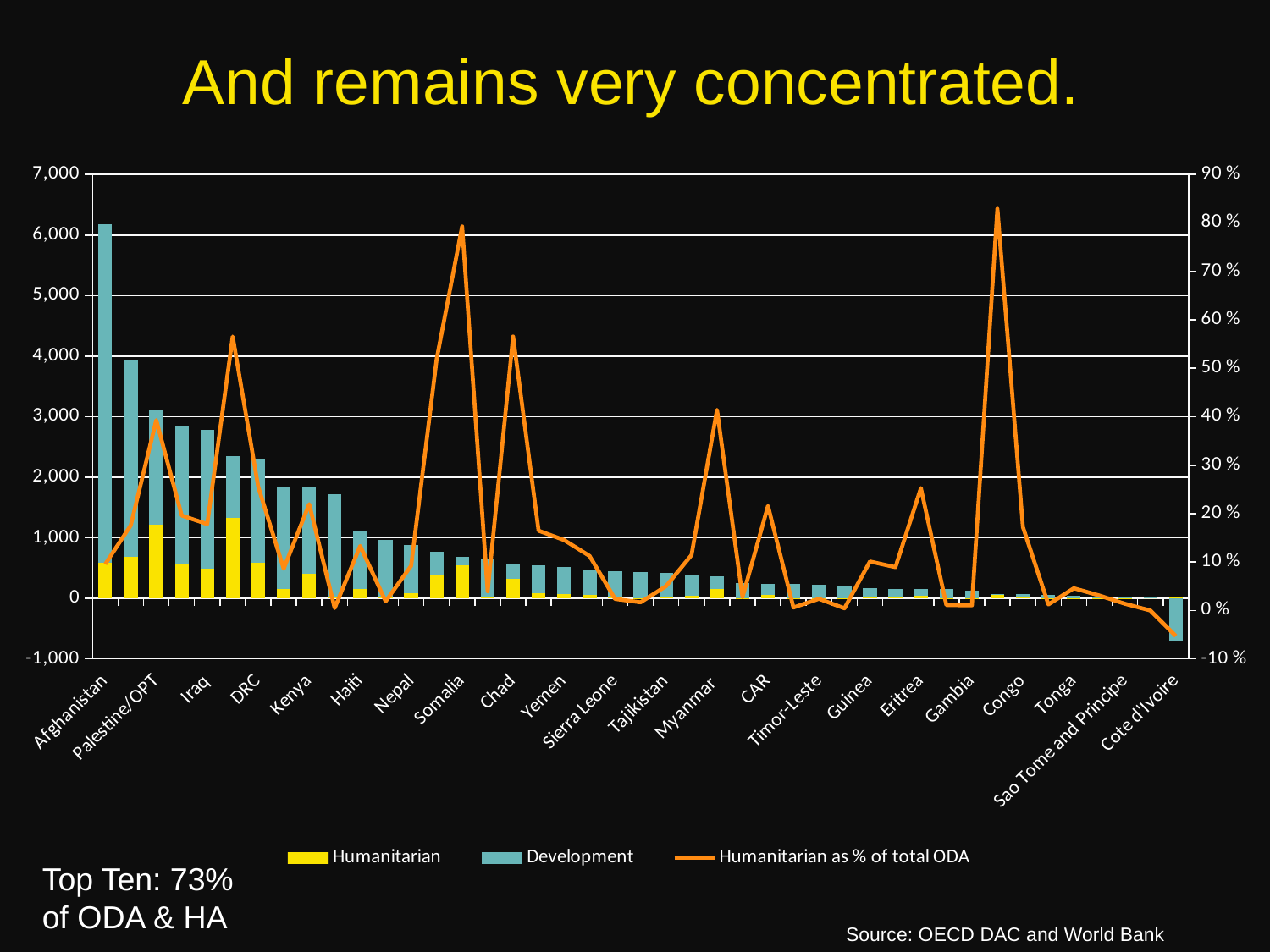
Is the total bar value for Kenya greater or less than 2,000? less Is the total bar value for Afghanistan greater or less than 5,000? greater Is the total bar value for Palestine/OPT greater or less than 3,000? greater What kind of chart is shown on the slide? Combination bar and line chart What is the title of the slide? And remains very concentrated. How many series does the legend list? 3 Which country has the tallest stacked bar? Afghanistan Which has the larger total bar, Afghanistan or Iraq? Afghanistan Do the stacked bar totals generally rise or fall from left to right across the x axis? fall